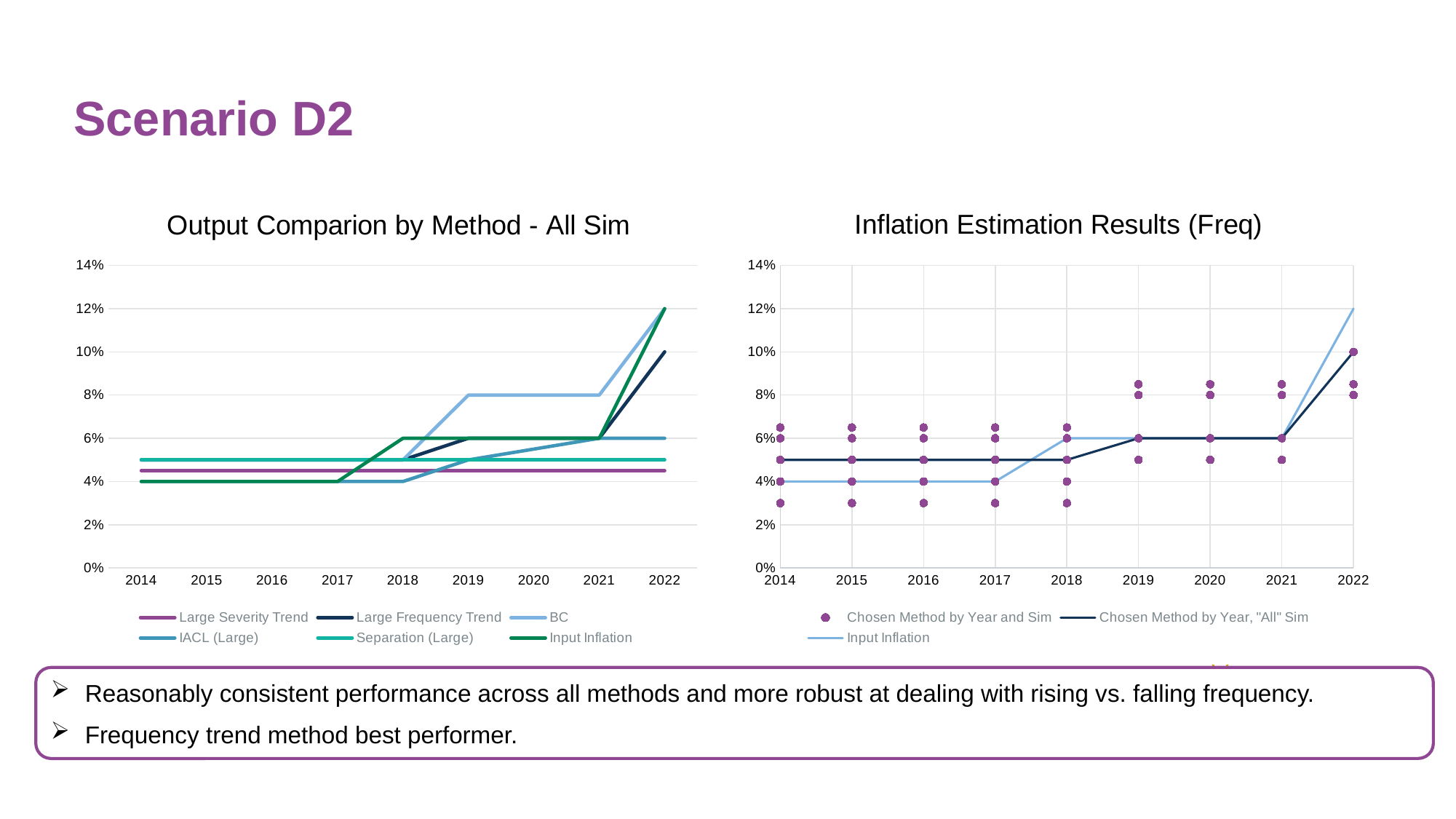
In the 'Inflation Estimation Results (Freq)' chart, what is the value of Input Inflation in 2022? 12% What kind of chart is the 'Output Comparion by Method - All Sim' chart? line chart In the 'Output Comparion by Method - All Sim' chart, does the BC series rise or fall from 2014 to 2022? rise How many series does the legend of the 'Output Comparion by Method - All Sim' chart list? 6 What is the title of the chart on the right side of the slide? Inflation Estimation Results (Freq) In the 'Inflation Estimation Results (Freq)' chart, what is the value of 'Chosen Method by Year, "All" Sim' in 2022? 10% In the 'Output Comparion by Method - All Sim' chart, which is larger in 2022: BC or Large Frequency Trend? BC In the 'Output Comparion by Method - All Sim' chart, what is the value of BC in 2020? 8% In the 'Output Comparion by Method - All Sim' chart, what is the value of Input Inflation in 2022? 12% How many years are shown on the x axis of the 'Output Comparion by Method - All Sim' chart? 9 How many series does the legend of the 'Inflation Estimation Results (Freq)' chart list? 3 In the 'Output Comparion by Method - All Sim' chart, is the value for Large Severity Trend in 2022 greater or less than 6%? less